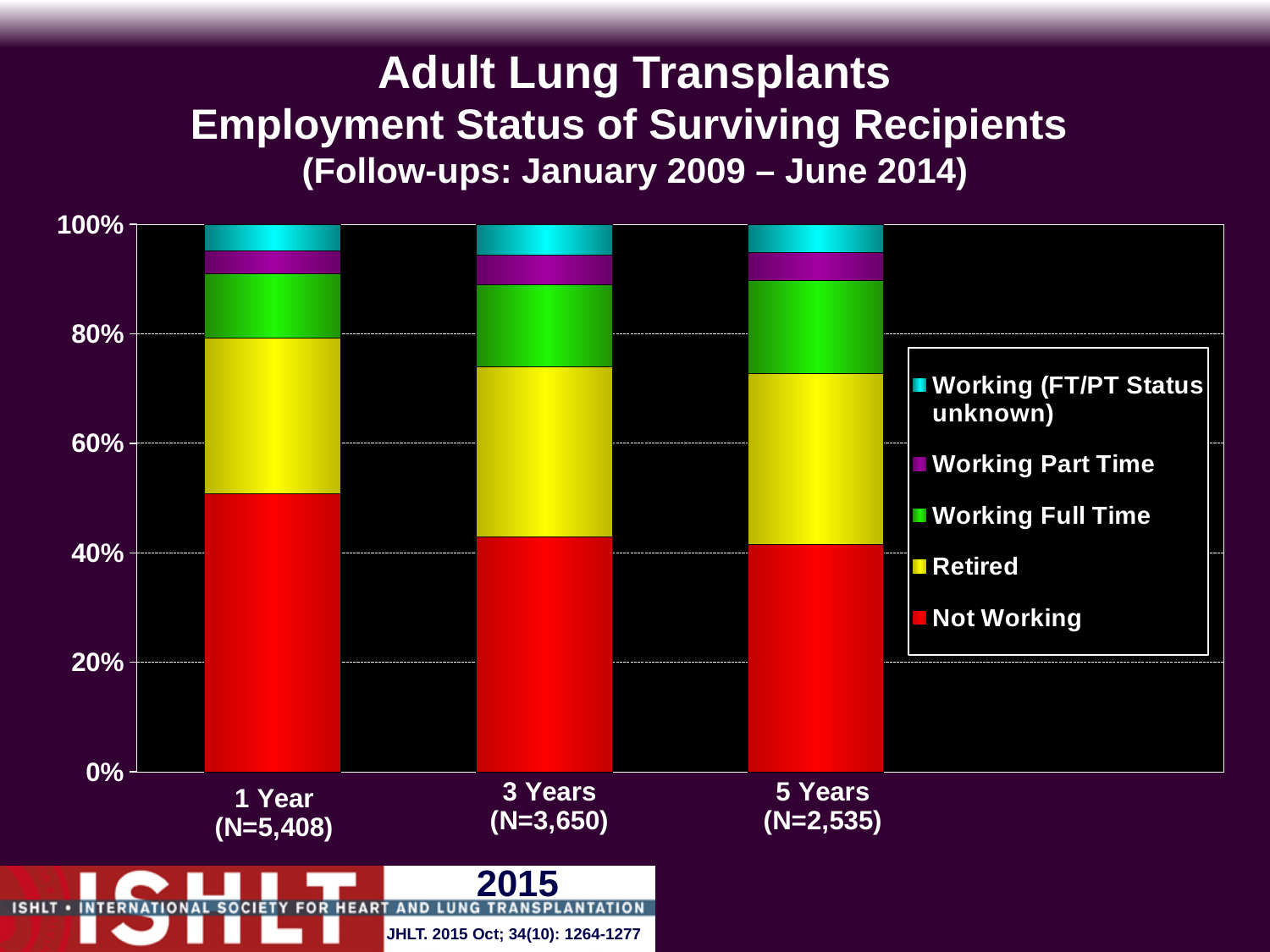
Does the Not Working share rise or fall from 1 Year to 5 Years? fall How many follow-up time points (categories) are shown on the x axis? 3 Is the Not Working share at 5 Years greater or less than 60%? less What kind of chart is shown on the slide? stacked bar chart At which follow-up time point is the Not Working segment the largest? 1 Year How many series does the legend list? 5 Which employment status is shown by the red segment at the bottom of each bar? Not Working Is the Not Working share at 1 Year greater or less than 60%? less What is the N (number of recipients) shown for the 1 Year follow-up? N=5,408 Is the Not Working share at 1 Year greater or less than 40%? greater Which is larger, the Not Working share at 1 Year or at 3 Years? 1 Year